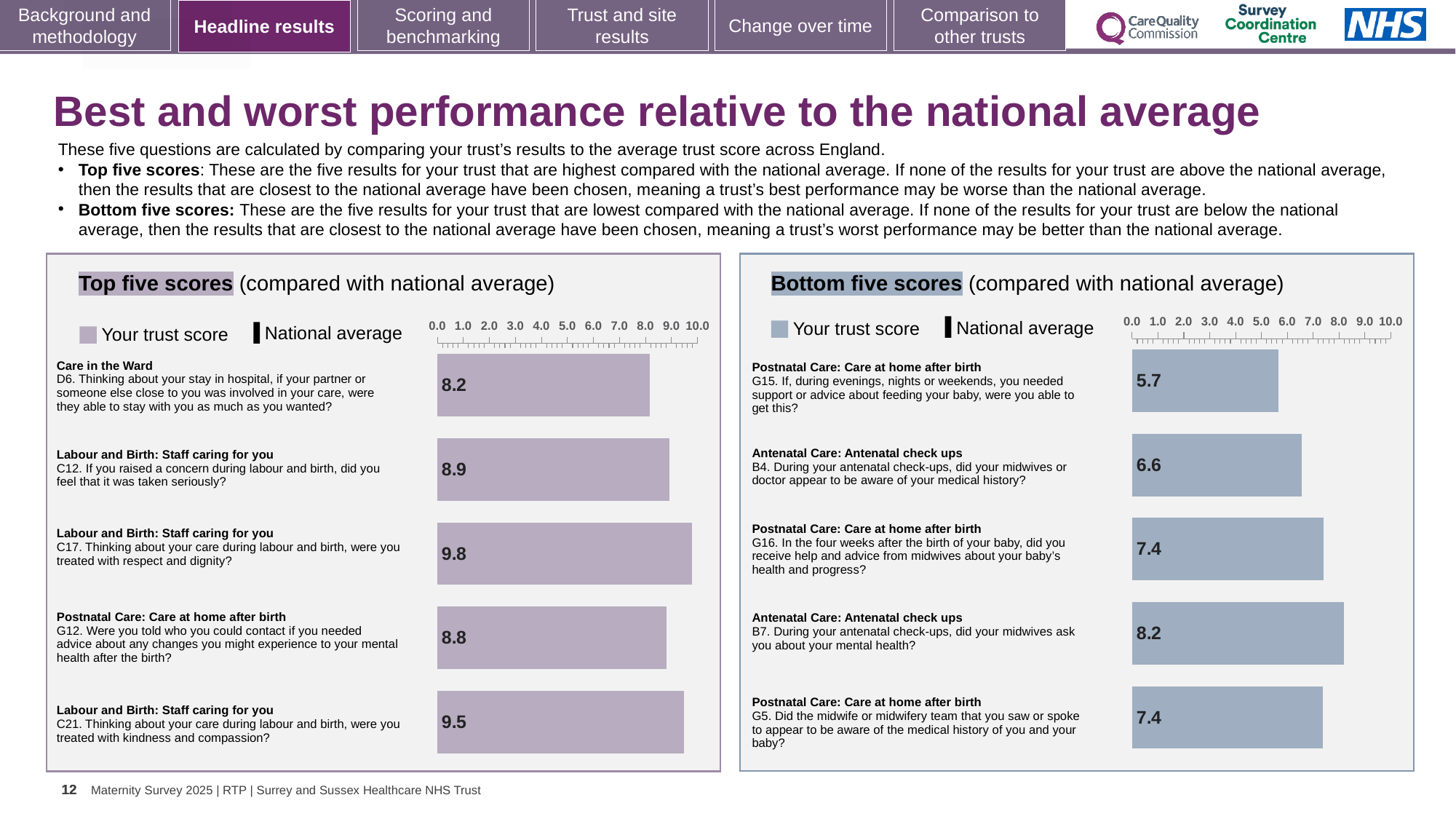
In the Bottom five scores chart, what is the trust score for question G15 (support or advice about feeding your baby during evenings, nights or weekends)? 5.7 In the Top five scores chart, which question has the highest trust score? C17 (9.8) In the Bottom five scores chart, what is the difference between the trust scores for B7 and G15? 2.5 In the Bottom five scores chart, which question has the highest trust score? B7 (8.2) In the Top five scores chart, what is the trust score for question G12 (told who to contact about changes to your mental health after the birth)? 8.8 In the Bottom five scores chart, which question has the lowest trust score? G15 (5.7) How many bars are shown in the Top five scores chart? 5 In the Top five scores chart, what is the difference between the trust scores for C21 and D6? 1.3 In the Top five scores chart, what is the trust score for question C17 (treated with respect and dignity during labour and birth)? 9.8 How many entries does the legend of the Top five scores chart list? 2 What type of chart is used in the Bottom five scores panel? Bar chart In the Bottom five scores chart, which has the larger trust score: B4 or B7? B7